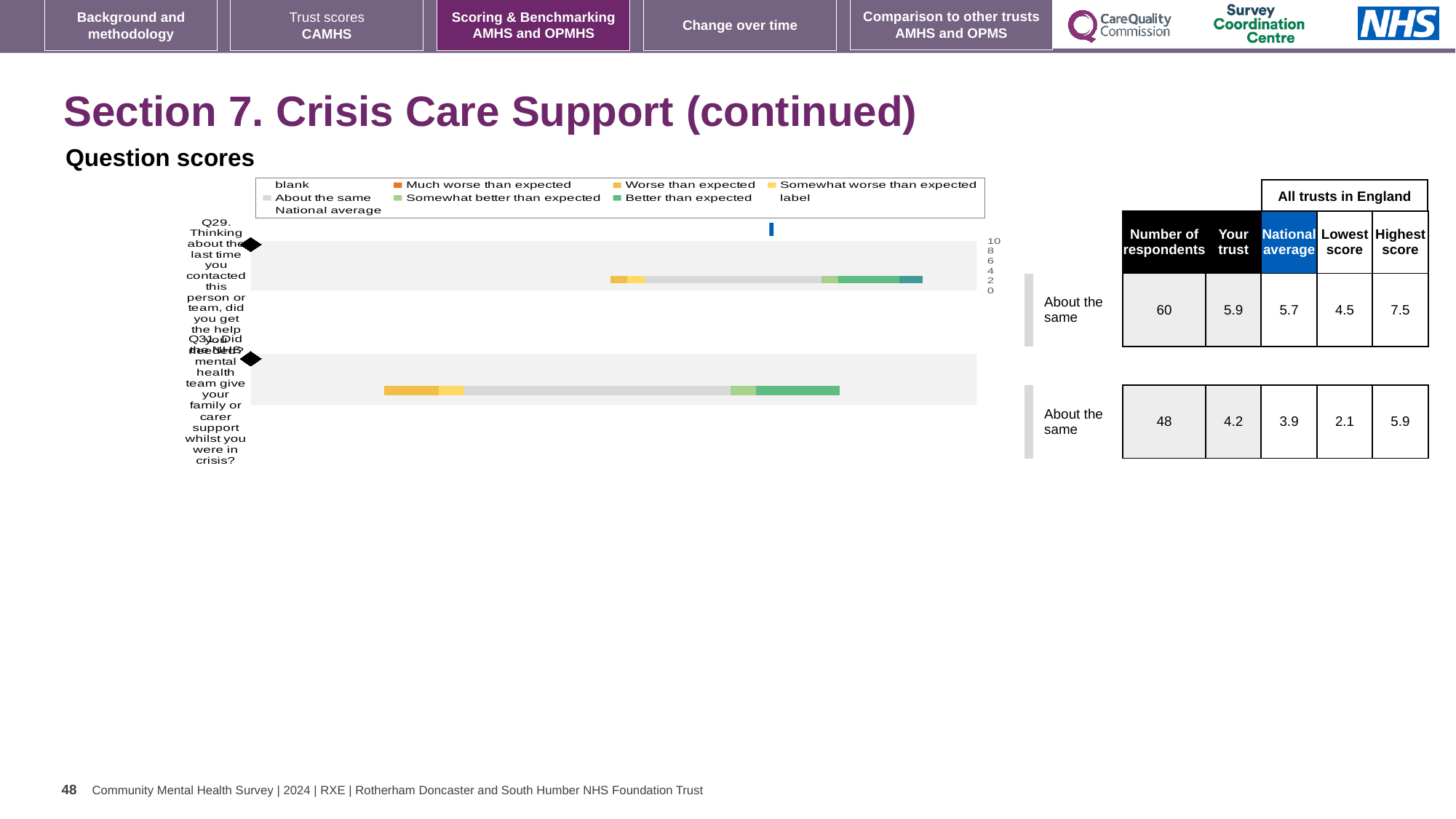
How many questions (categories) are plotted in the chart? 2 What kind of chart is shown under 'Question scores'? bar chart In the table beside the chart, what is the 'Your trust' score for Q29? 5.9 What is the difference between the 'Your trust' score and the national average for Q31? 0.3 Which two question numbers are plotted in the chart? Q29 and Q31 What is the difference between the highest score and the lowest score for Q29? 3.0 In the table beside the chart, what is the lowest score among all trusts in England for Q29? 4.5 In the table beside the chart, what is the national average for Q31? 3.9 In the table beside the chart, what is the highest score among all trusts in England for Q31? 5.9 For Q29, which is larger: the 'Your trust' score or the national average? Your trust What benchmark rating is shown next to the chart for Q31? About the same In the table beside the chart, what is the number of respondents for Q29? 60